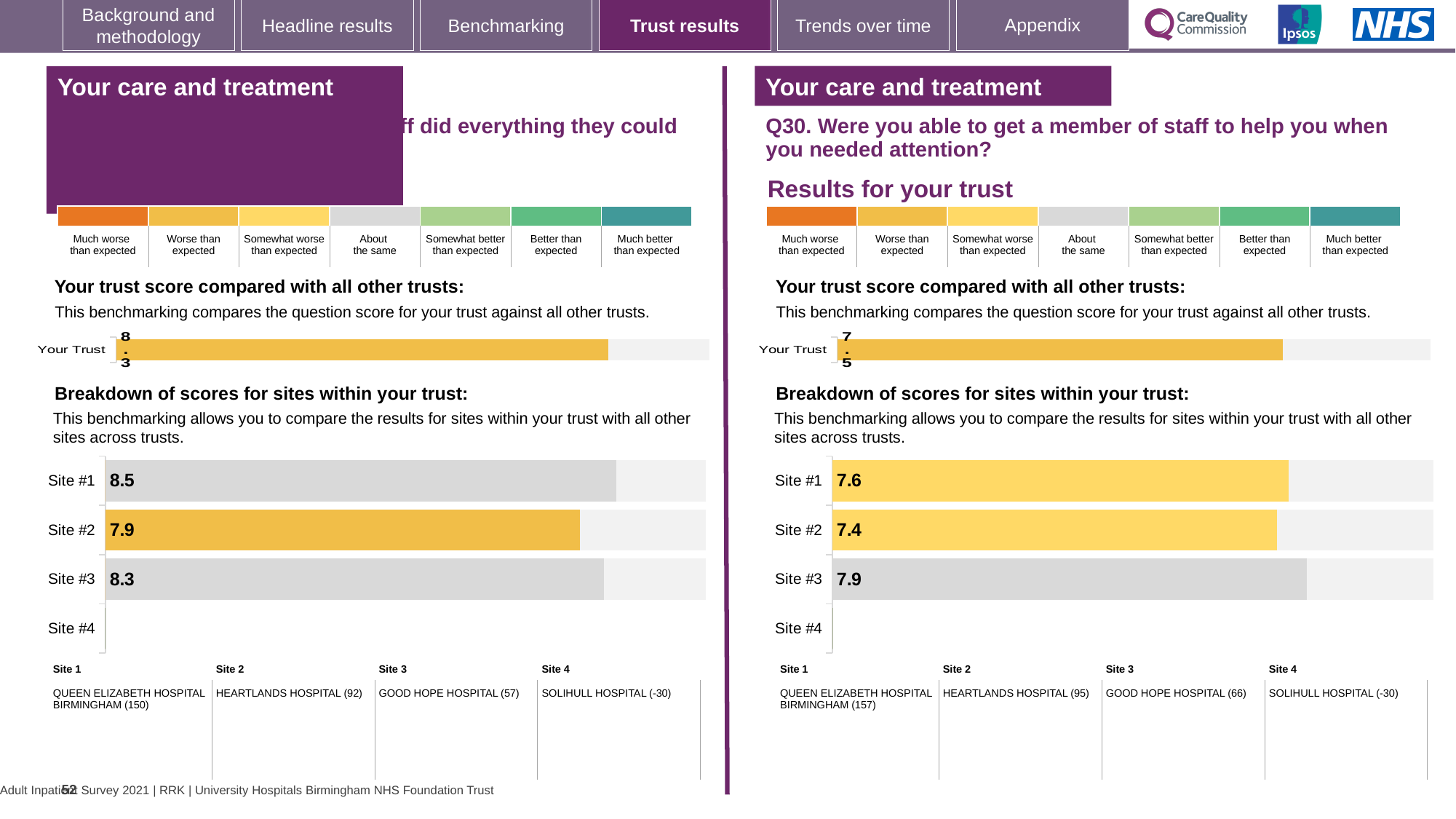
In the right-hand chart for Q30, which site has the lowest score among the sites with a bar? Site #2 What is the 'Your Trust' score shown in the left-hand benchmarking bar? 8.3 In the left-hand site breakdown chart, which site has the highest score? Site #1 In the right-hand chart for Q30, which has the higher score, Site #1 or Site #3? Site #3 What type of chart is used for the breakdown of scores for sites within the trust? Bar chart In the right-hand chart for Q30, what is the score for Site #3? 7.9 In the left-hand site breakdown chart, what is the score for Site #2? 7.9 What is the 'Your Trust' score shown in the right-hand Q30 benchmarking bar? 7.5 In the left-hand site breakdown chart, which has the higher score, Site #2 or Site #3? Site #3 In the right-hand chart for Q30, what is the difference between the scores for Site #3 and Site #2? 0.5 In the left-hand site breakdown chart, what is the difference between the scores for Site #1 and Site #2? 0.6 In the right-hand chart for Q30, what is the score for Site #1? 7.6